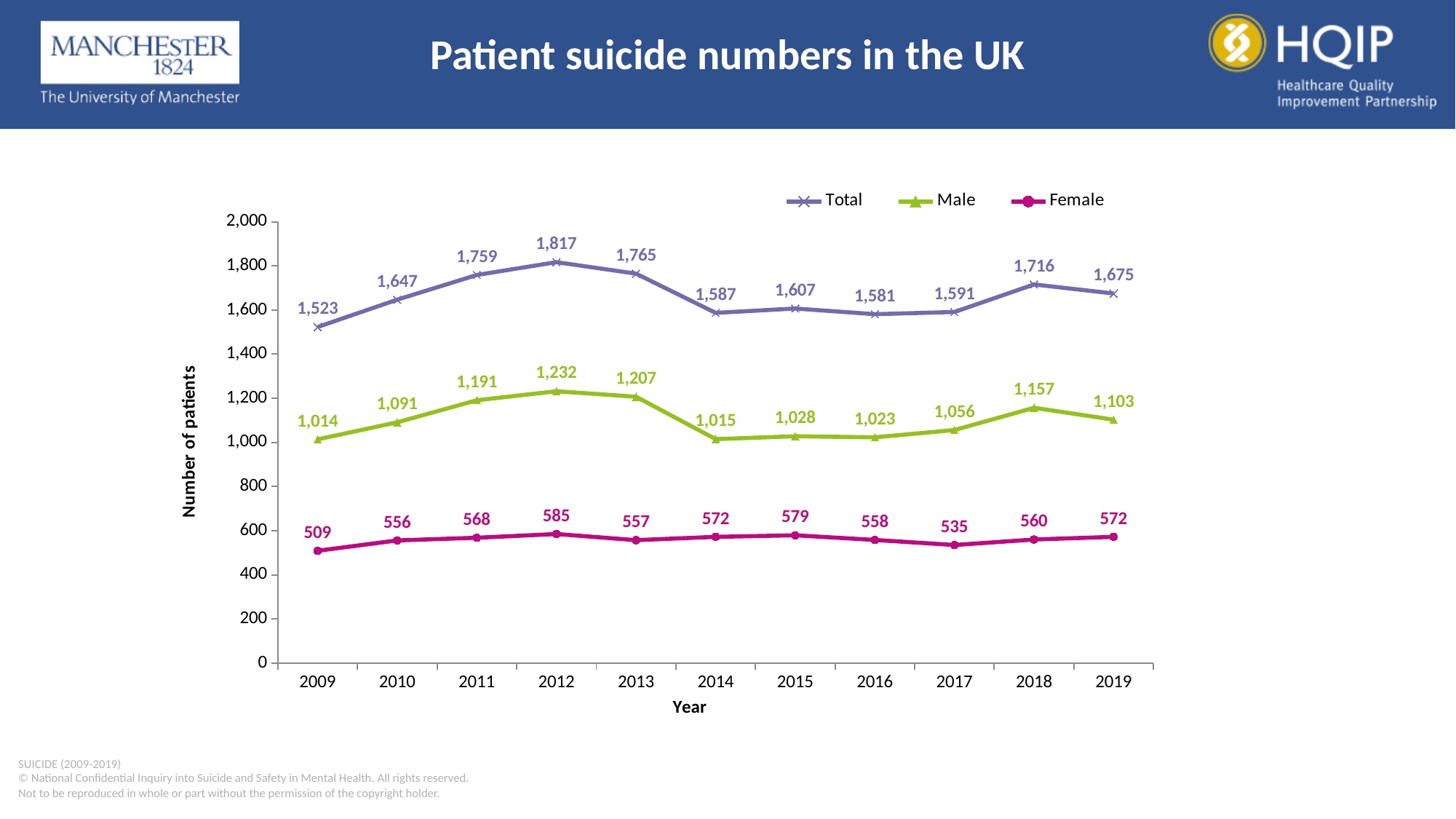
What was the Female value in 2017? 535 What is the difference between the Total values for 2018 and 2019? 41 Did the Total series rise or fall from 2009 to 2012? Rise Which is larger, the Male value in 2011 or the Male value in 2018? 2011 In which year was the Total series highest? 2012 What was the Male value in 2014? 1,015 How many years are shown on the x axis? 11 How many series does the legend list? 3 What kind of chart is shown on the slide? Line chart What is the label of the y axis? Number of patients What was the Total number of patient suicides in 2012? 1,817 In which year was the Female series lowest? 2009